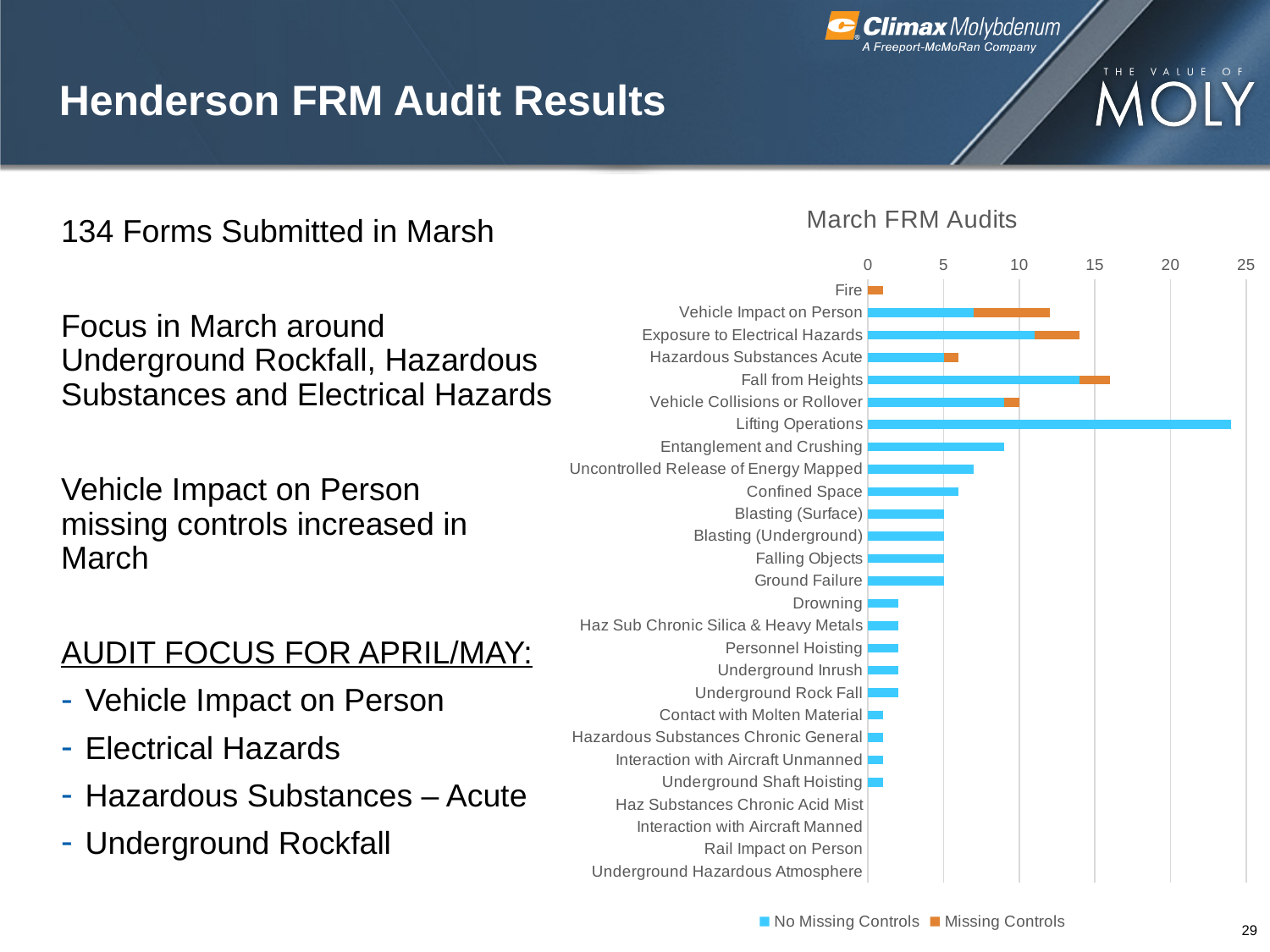
Which category has the longest bar in the chart? Lifting Operations Which has a larger total bar, Exposure to Electrical Hazards or Hazardous Substances Acute? Exposure to Electrical Hazards Is the total value for Lifting Operations greater or less than 20? greater How many categories are listed on the vertical axis of the chart? 27 Which series is shown in orange in the chart? Missing Controls Is the value for Entanglement and Crushing greater or less than 10? less What is the title of the chart? March FRM Audits Which has a larger bar, Entanglement and Crushing or Confined Space? Entanglement and Crushing Is the total value for Fall from Heights greater or less than 15? greater What kind of chart is shown on the slide? Stacked horizontal bar chart How many series does the chart legend list? 2